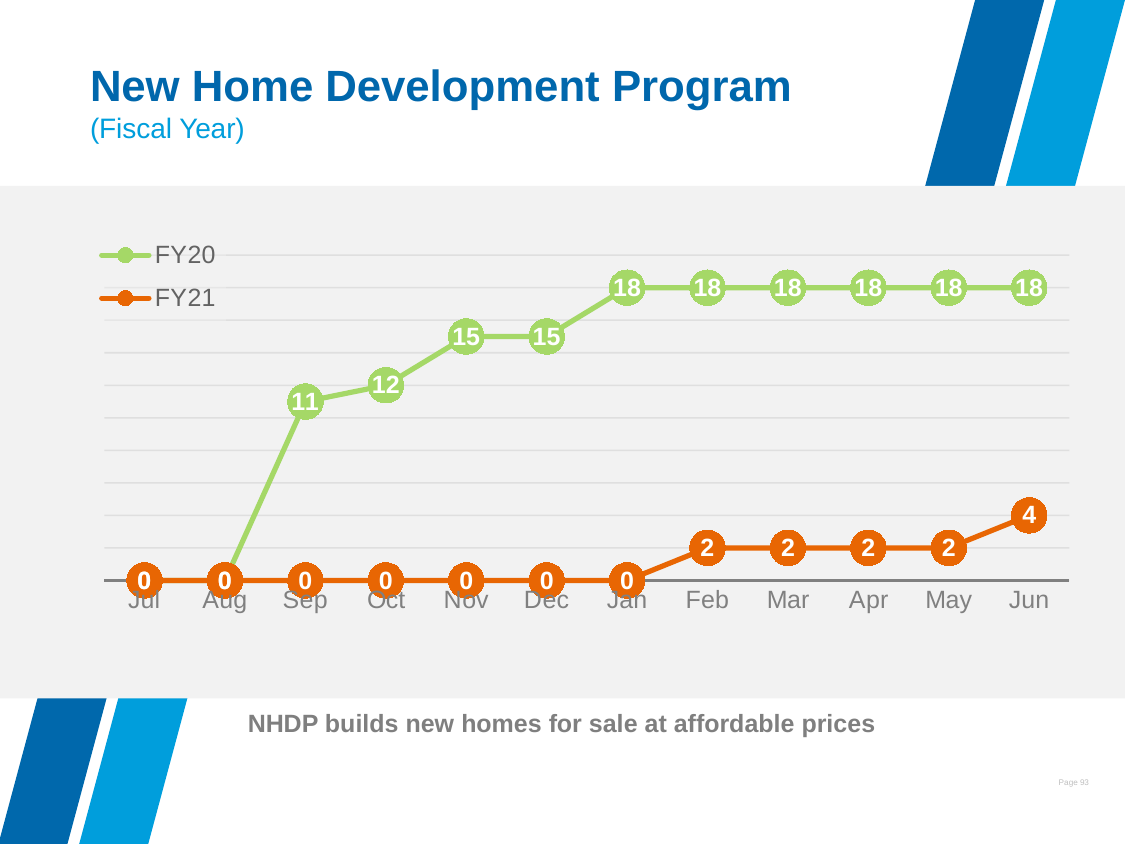
What is the FY20 value for Nov? 15 What is the highest value reached by the FY20 series? 18 How many series does the legend list? 2 Which series has the larger value in Feb, FY20 or FY21? FY20 Does the FY21 series rise or fall from Jan to Jun? Rise In which month does the FY21 series reach its highest value? Jun What is the FY21 value for Mar? 2 What is the difference between the FY20 values for Oct and Nov? 3 What is the FY21 value for Jun? 4 What is the difference between the FY20 and FY21 values for Jun? 14 What is the FY20 value for Sep? 11 What kind of chart is shown on the slide? Line chart